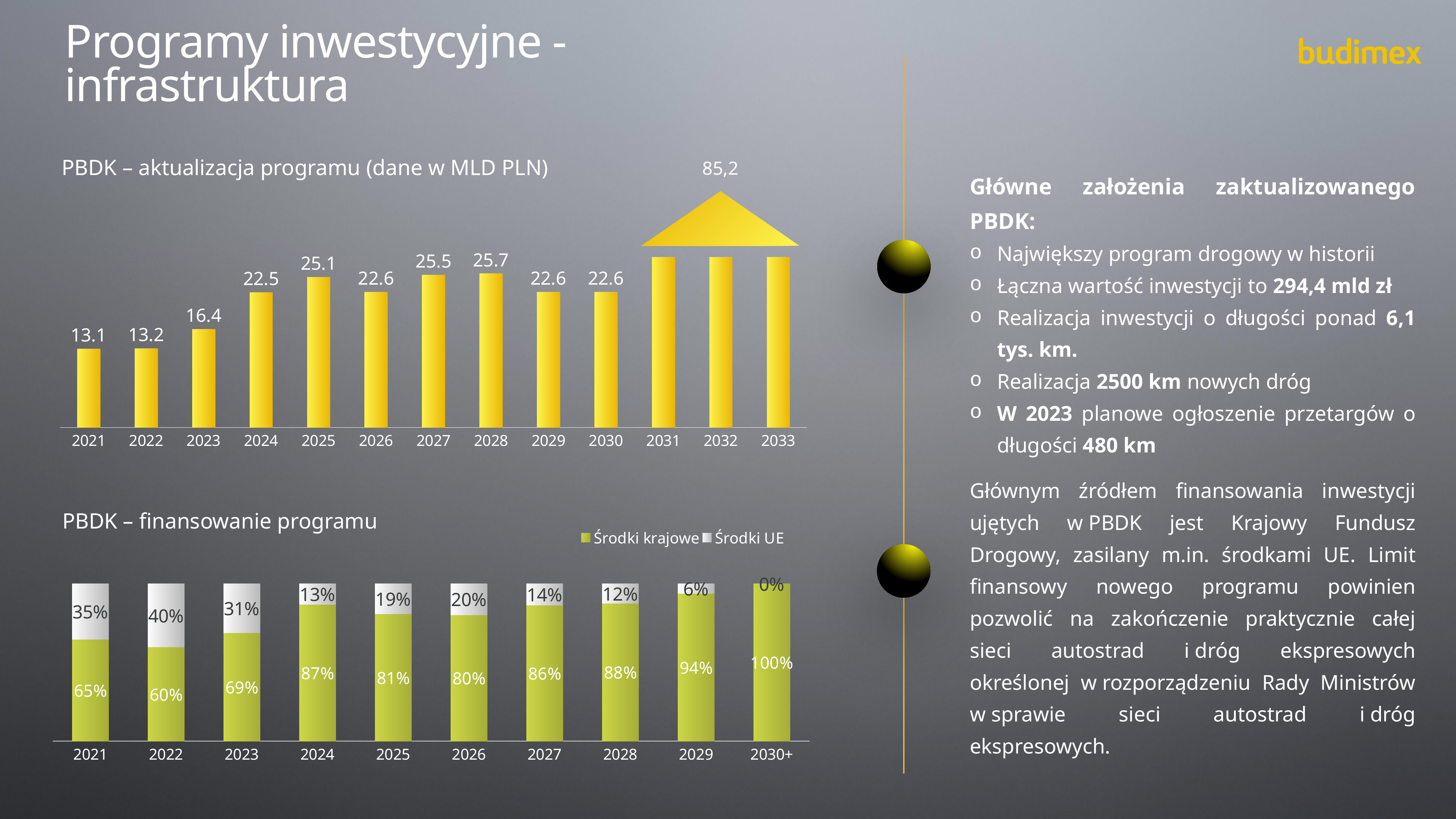
In the chart 'PBDK – aktualizacja programu', what is the value for 2024? 22.5 In the chart 'PBDK – aktualizacja programu', which is larger, the value for 2023 or the value for 2026? 2026 In the chart 'PBDK – aktualizacja programu', what is the difference between the values for 2025 and 2021? 12.0 What kind of chart is 'PBDK – finansowanie programu'? Stacked bar chart In the chart 'PBDK – finansowanie programu', what is the share of Środki krajowe in 2029? 94% In the chart 'PBDK – finansowanie programu', how many series does the legend list? 2 In the chart 'PBDK – aktualizacja programu', which year from 2021 to 2030 has the lowest value? 2021 In the chart 'PBDK – aktualizacja programu', what is the combined value shown for 2031–2033? 85,2 In the chart 'PBDK – finansowanie programu', which year has the highest share of Środki UE? 2022 In the chart 'PBDK – aktualizacja programu', how many years are shown on the x axis? 13 In the chart 'PBDK – finansowanie programu', what is the share of Środki UE in 2022? 40% In the chart 'PBDK – aktualizacja programu', what is the value for 2028? 25.7